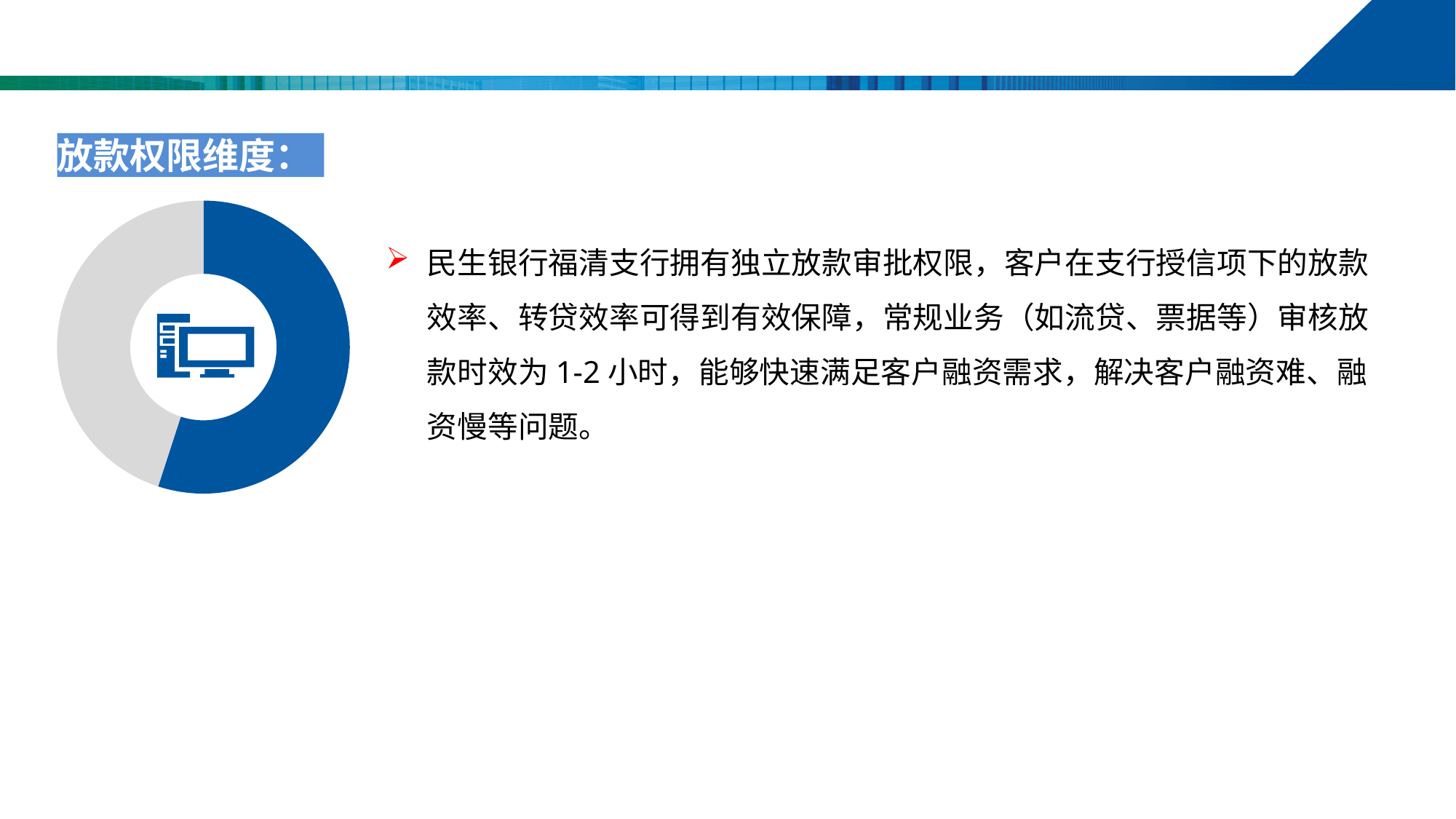
In the doughnut chart on the left, which slice is smaller, the blue one or the grey one? The grey one What two colours are used for the slices of the doughnut chart on the left? Blue and grey In the doughnut chart on the left, which slice is larger, the blue one or the grey one? The blue one How many slices does the doughnut chart on the left have? 2 Does the doughnut chart on the left show any data labels or a legend? No What kind of chart is shown on the left of the slide? Doughnut (pie) chart